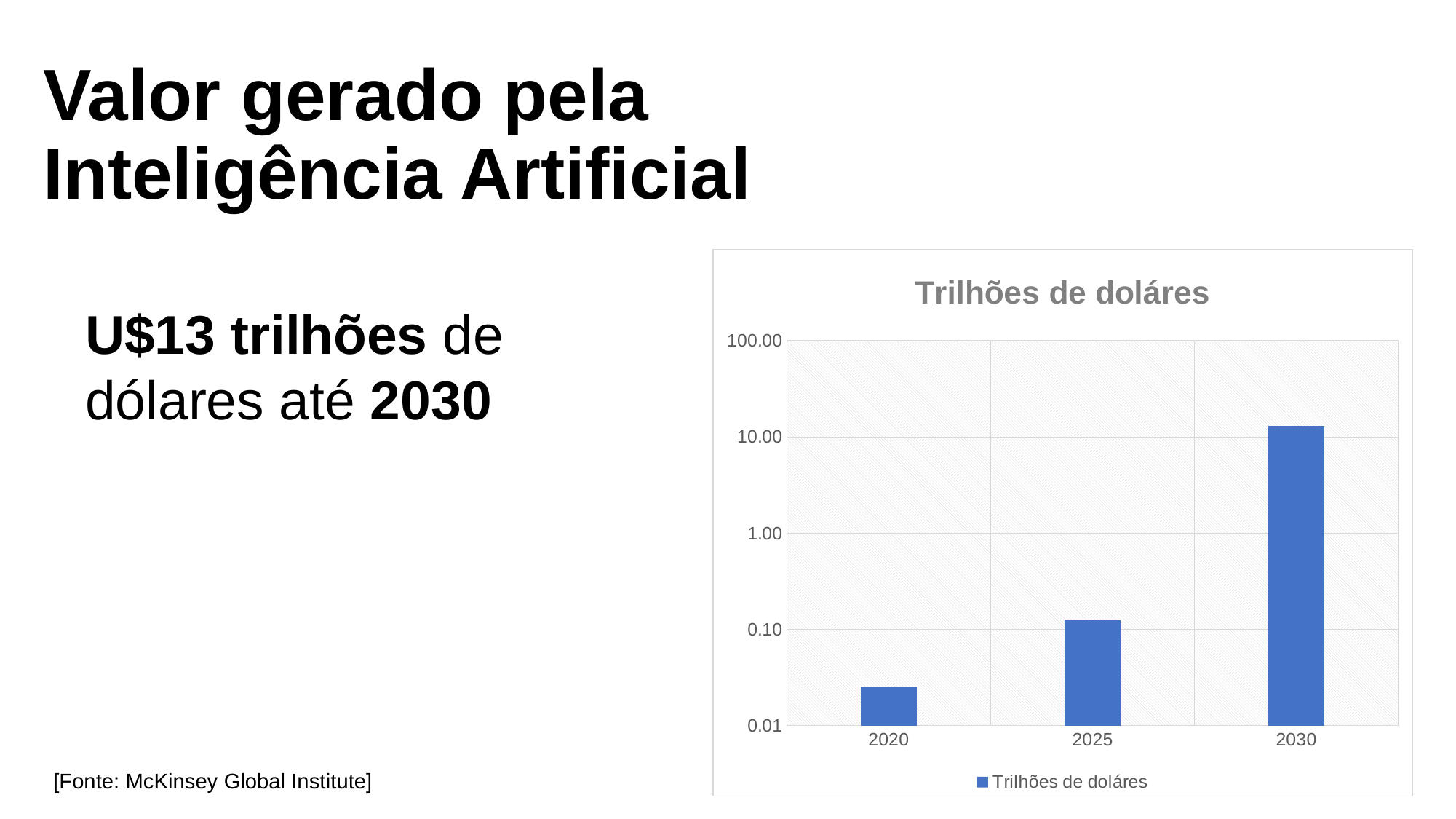
How many categories are shown on the x axis of the chart? 3 How many series does the chart legend list? 1 Which year has the lowest value in the chart? 2020 Which has the larger value, 2020 or 2025? 2025 Is the value for 2025 greater or less than 1.00? less Do the values rise or fall from 2020 to 2030? rise Which year has the highest value in the chart? 2030 Is the value for 2030 greater or less than 100.00? less What kind of chart is shown on the slide? bar chart Is the value for 2030 greater or less than 10.00? greater What is the title of the chart? Trilhões de doláres